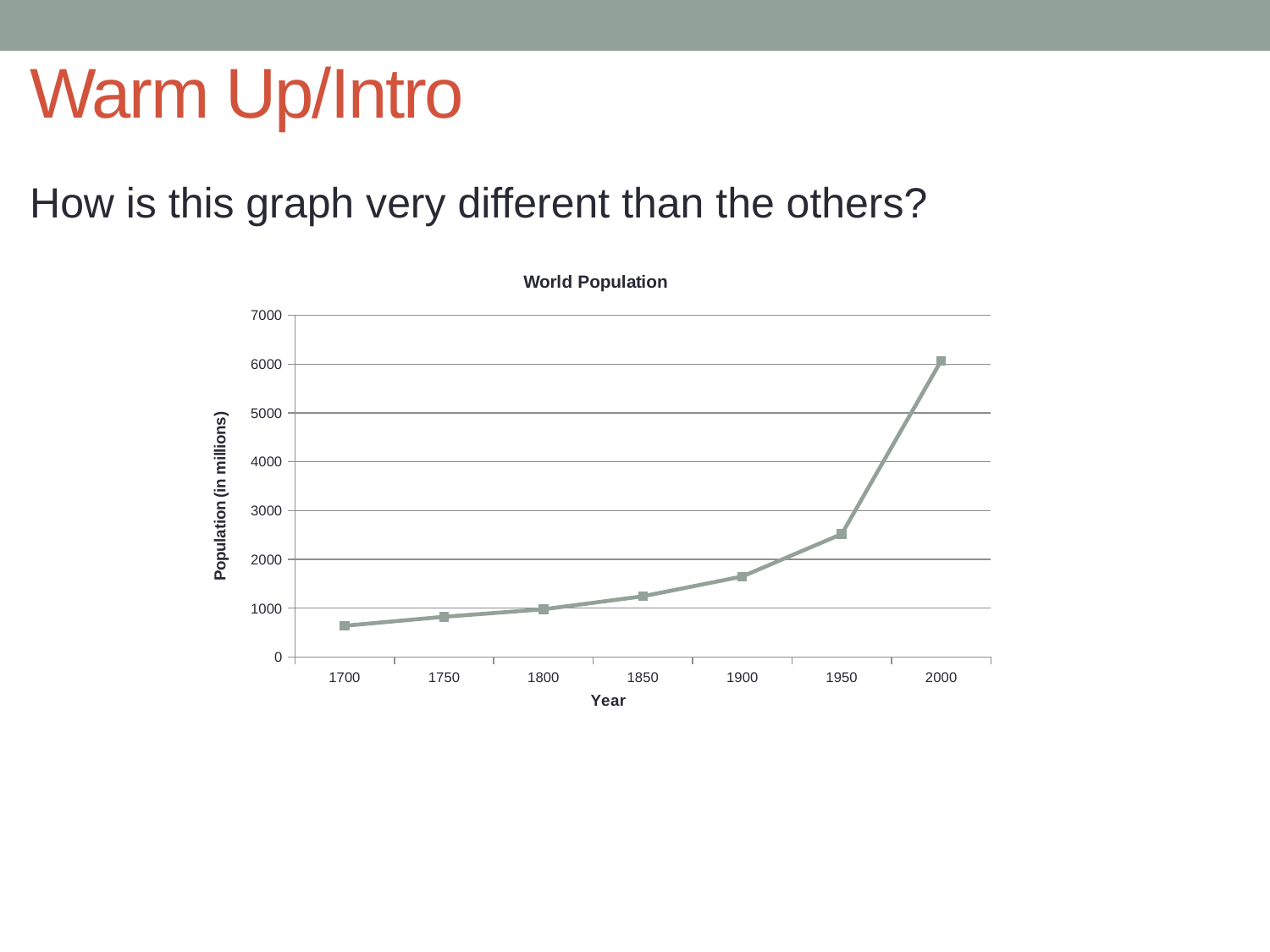
Which year has the lowest population value on the chart? 1700 Which year has the larger population value, 1900 or 1950? 1950 What is the title of the chart? World Population How many data points are plotted on the chart? 7 Is the population value for 1950 greater or less than 3000? less What is the label on the vertical axis of the chart? Population (in millions) Is the population value for 1700 greater or less than 1000? less Is the population value for 1900 greater or less than 2000? less Do the population values rise or fall as the years increase along the x axis? rise What kind of chart is shown on the slide? line chart Which year has the highest population value on the chart? 2000